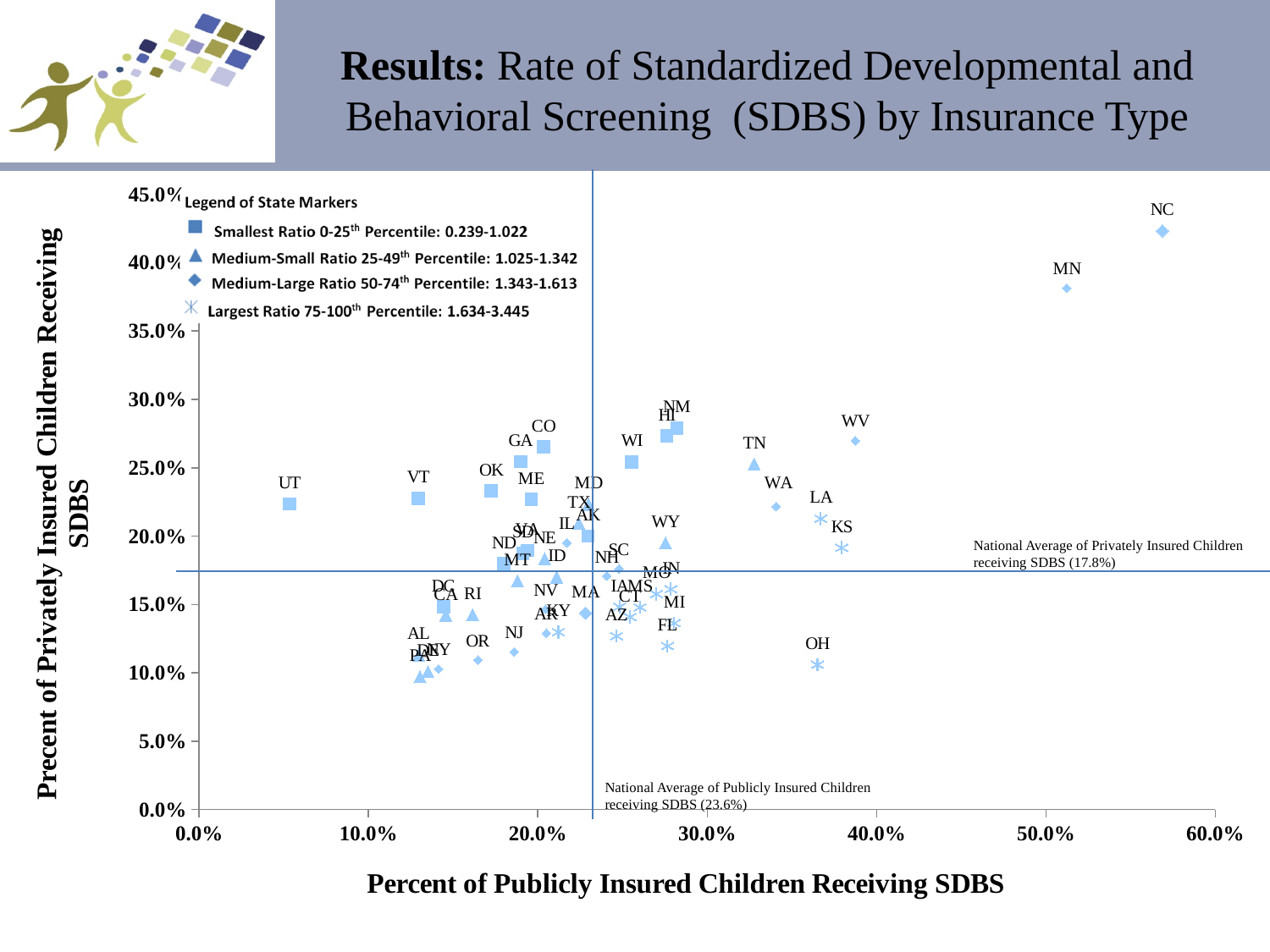
Which state has the lowest percent of publicly insured children receiving SDBS? UT Which state has a higher percent of privately insured children receiving SDBS, NC or MN? NC Which state has the highest percent of privately insured children receiving SDBS? NC What is the title of the x axis? Percent of Publicly Insured Children Receiving SDBS What is the national average of privately insured children receiving SDBS, as printed on the chart? 17.8% Is the percent of privately insured children receiving SDBS for NC greater or less than 40.0%? greater How many marker categories does the Legend of State Markers list? 4 What kind of chart is shown on the slide? scatter plot Is the percent of publicly insured children receiving SDBS for UT greater or less than 10.0%? less Is the percent of privately insured children receiving SDBS for MN greater or less than 35.0%? greater What is the national average of publicly insured children receiving SDBS, as printed on the chart? 23.6% Which state has a higher percent of publicly insured children receiving SDBS, WV or TN? WV